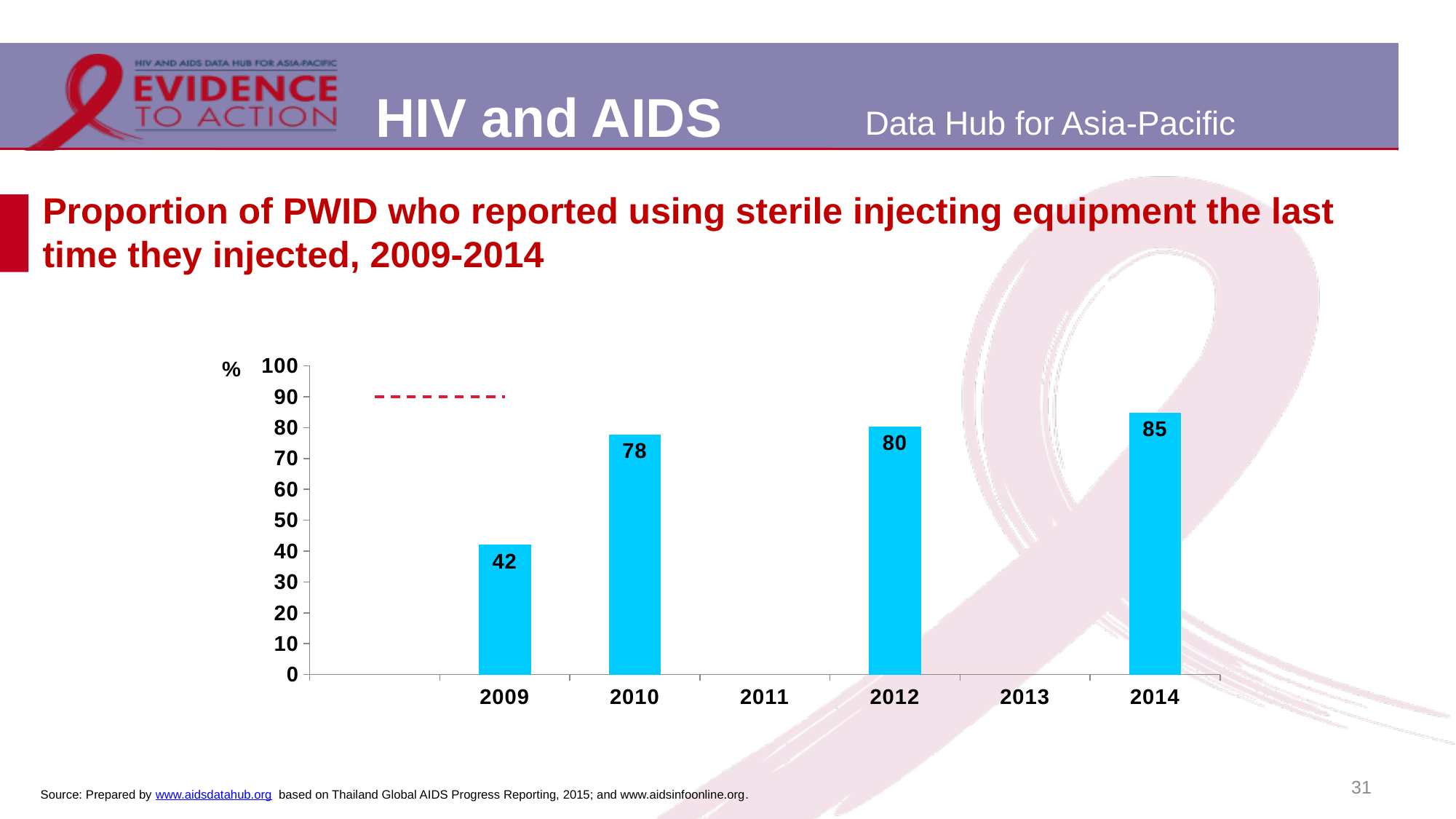
Is the value for 2009 greater or less than 50? less What is the value for 2014? 85 Which year has the highest value? 2014 Which is larger, the value for 2010 or the value for 2012? 2012 What is the value for 2012? 80 What is the value for 2010? 78 What is the value for 2009? 42 Do the values rise or fall from 2009 to 2014? rise Which year has the lowest value? 2009 How many years have a bar plotted? 4 What kind of chart is shown? bar chart What is the difference between the values for 2014 and 2009? 43